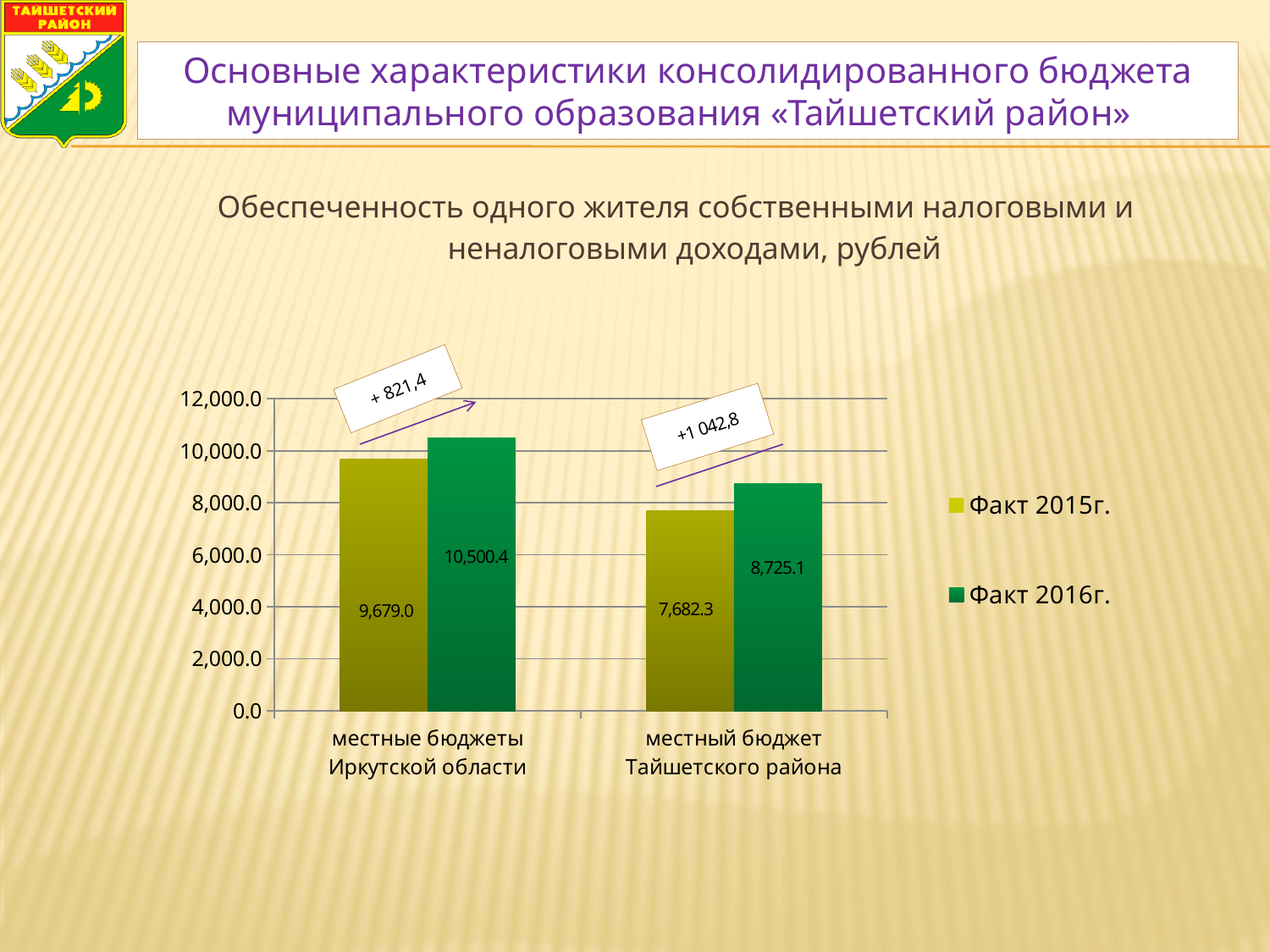
Which bar has the lowest value on the chart? Факт 2015г. for местный бюджет Тайшетского района What is the value for Факт 2015г. for местный бюджет Тайшетского района? 7,682.3 What is the difference between the Факт 2016г. and Факт 2015г. values for местный бюджет Тайшетского района? 1,042.8 What is the value for Факт 2015г. for местные бюджеты Иркутской области? 9,679.0 How many series does the legend list? 2 What kind of chart is shown on the slide? bar chart Is the Факт 2015г. value for местный бюджет Тайшетского района greater or less than 8,000.0? less Which is larger: the Факт 2016г. value for местные бюджеты Иркутской области or the Факт 2016г. value for местный бюджет Тайшетского района? местные бюджеты Иркутской области Which bar has the highest value on the chart? Факт 2016г. for местные бюджеты Иркутской области What is the value for Факт 2016г. for местные бюджеты Иркутской области? 10,500.4 What is the difference between the Факт 2016г. and Факт 2015г. values for местные бюджеты Иркутской области? 821.4 What is the value for Факт 2016г. for местный бюджет Тайшетского района? 8,725.1